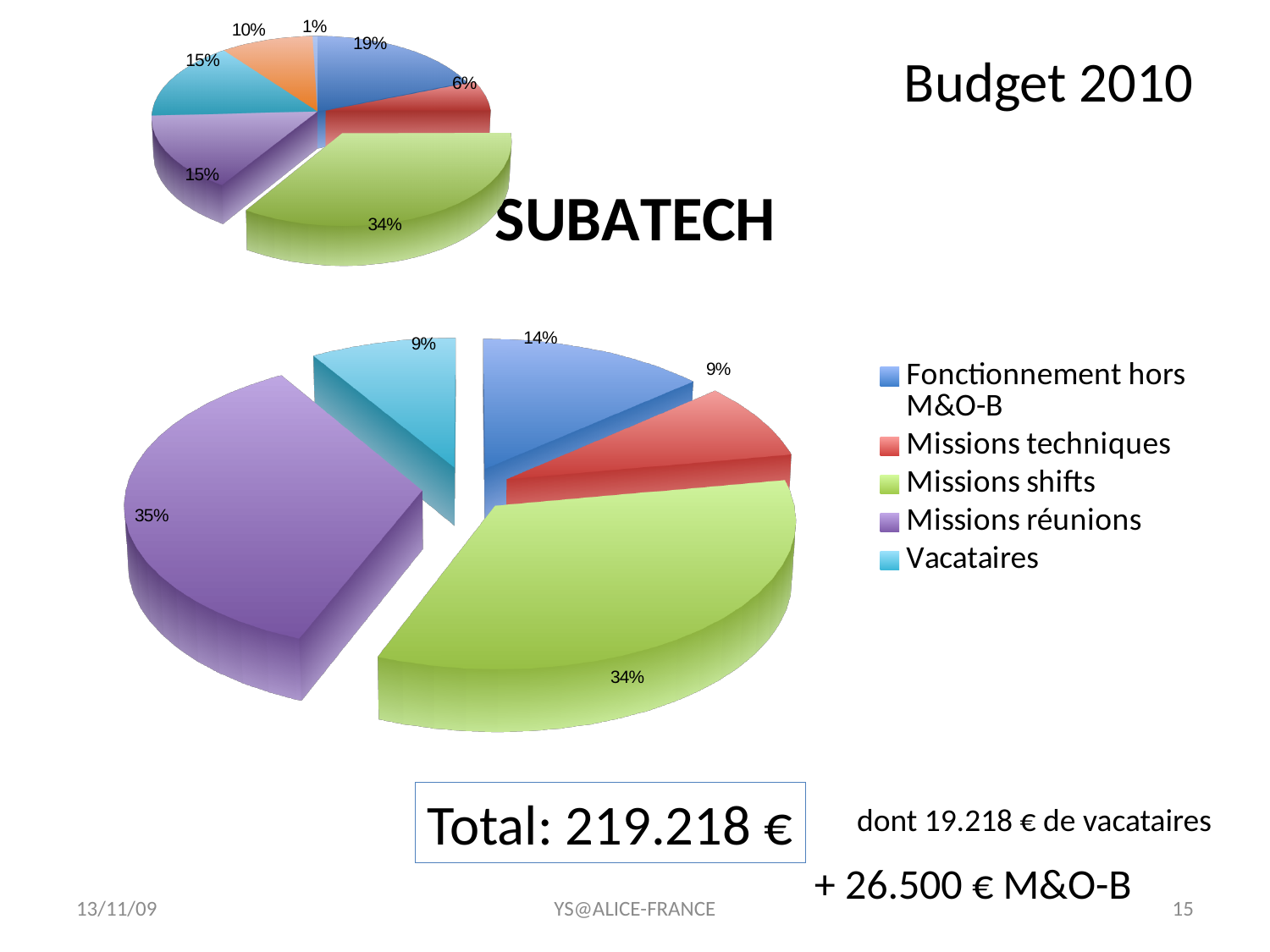
In the large pie chart, what share is labelled for Missions réunions? 35% In the large pie chart, what colour is the Missions réunions slice? Purple In the large pie chart, which category has the largest share? Missions réunions In the large pie chart, what share is labelled for Vacataires? 9% In the large pie chart, what share is labelled for Fonctionnement hors M&O-B? 14% In the large pie chart, which is larger: Missions shifts or Fonctionnement hors M&O-B? Missions shifts What kind of chart is the large chart in the lower left of the slide? Pie chart How many slices does the small pie chart at the top left of the slide have? 7 In the large pie chart, what share is labelled for Missions shifts? 34% In the large pie chart, how many percentage points larger is Missions réunions than Fonctionnement hors M&O-B? 21 How many entries does the legend of the large pie chart list? 5 In the small pie chart at the top left, what is the largest labelled share? 34%